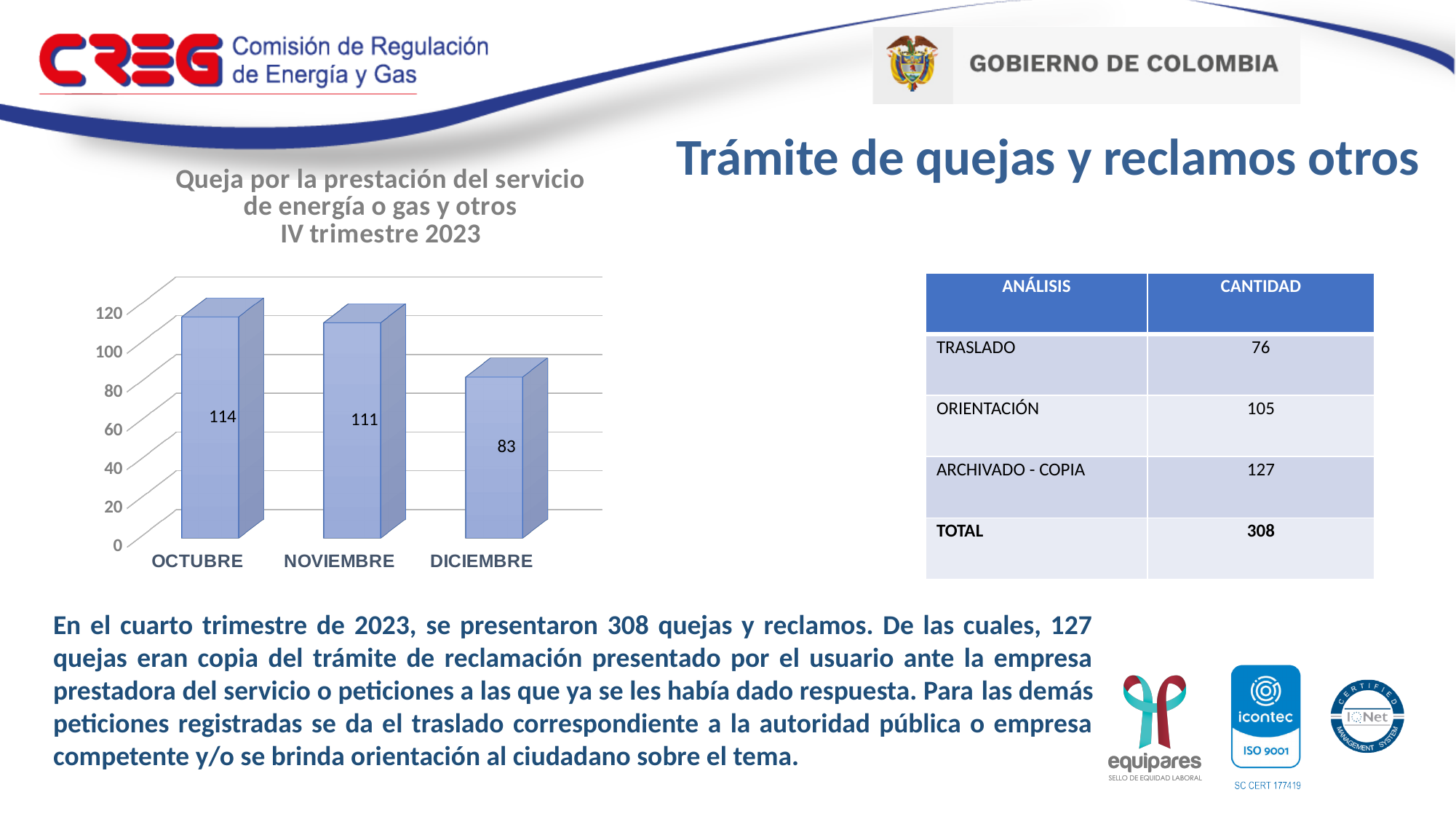
What kind of chart is shown on the slide? bar chart How many months are shown on the chart? 3 Which month has the lowest value? DICIEMBRE Which month has the highest value? OCTUBRE What is the value for OCTUBRE? 114 Which is larger, the value for NOVIEMBRE or the value for DICIEMBRE? NOVIEMBRE What is the value for NOVIEMBRE? 111 What is the difference between the values for NOVIEMBRE and DICIEMBRE? 28 What is the difference between the values for OCTUBRE and DICIEMBRE? 31 Do the values rise or fall from OCTUBRE to DICIEMBRE? fall Is the value for DICIEMBRE greater or less than 100? less What is the value for DICIEMBRE? 83